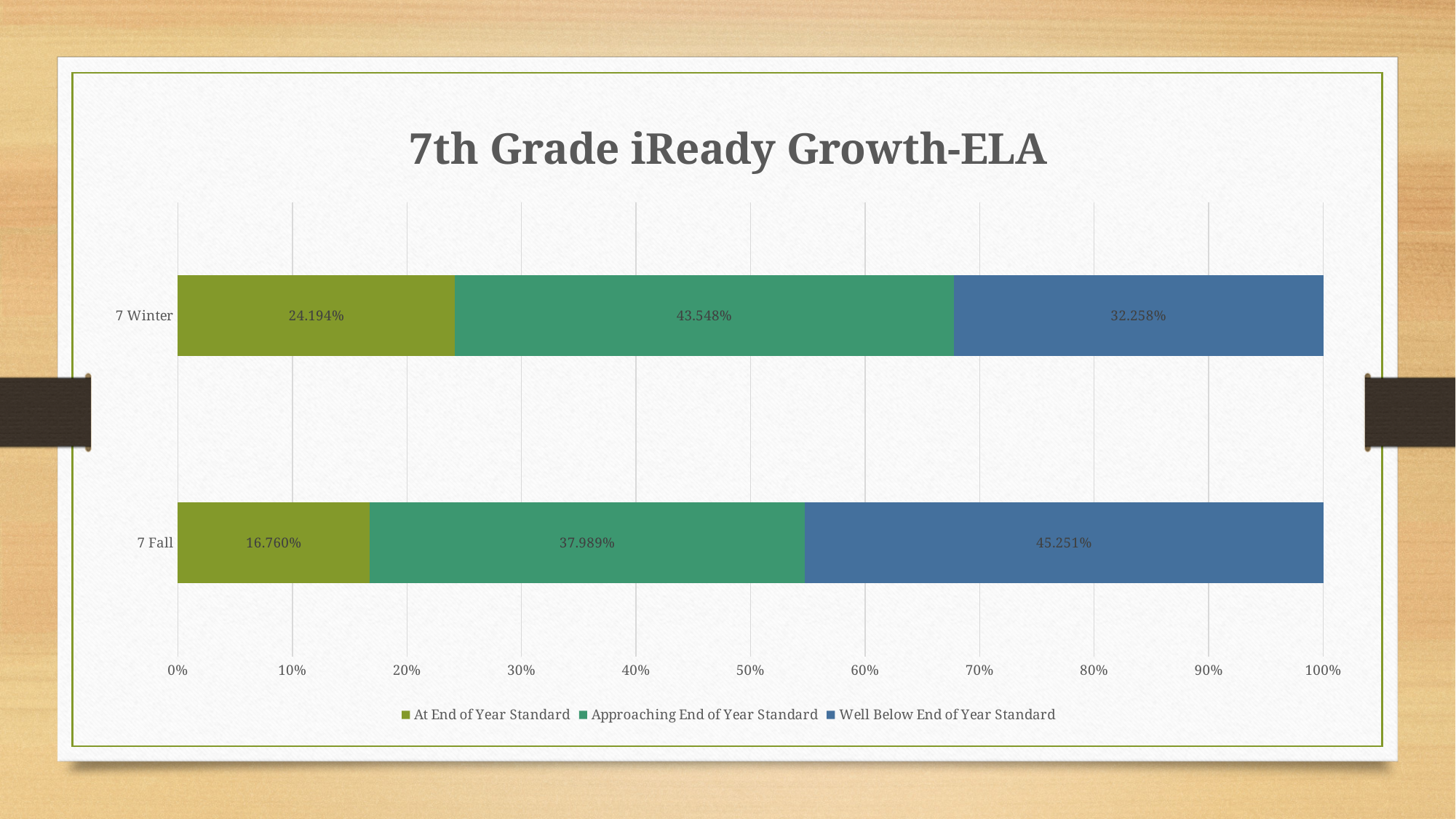
What kind of chart is shown on the slide? Stacked bar chart Which series has the largest value in 7 Fall? Well Below End of Year Standard What is the title of the chart? 7th Grade iReady Growth-ELA What is the value for Approaching End of Year Standard in 7 Winter? 43.548% Which category has the higher value for Well Below End of Year Standard, 7 Winter or 7 Fall? 7 Fall How many categories are shown on the chart? 2 How many series does the legend list? 3 Which series has the smallest value in 7 Winter? At End of Year Standard What is the difference between the At End of Year Standard values for 7 Winter and 7 Fall? 7.434% What is the value for At End of Year Standard in 7 Winter? 24.194% What is the value for At End of Year Standard in 7 Fall? 16.760% What is the value for Well Below End of Year Standard in 7 Fall? 45.251%